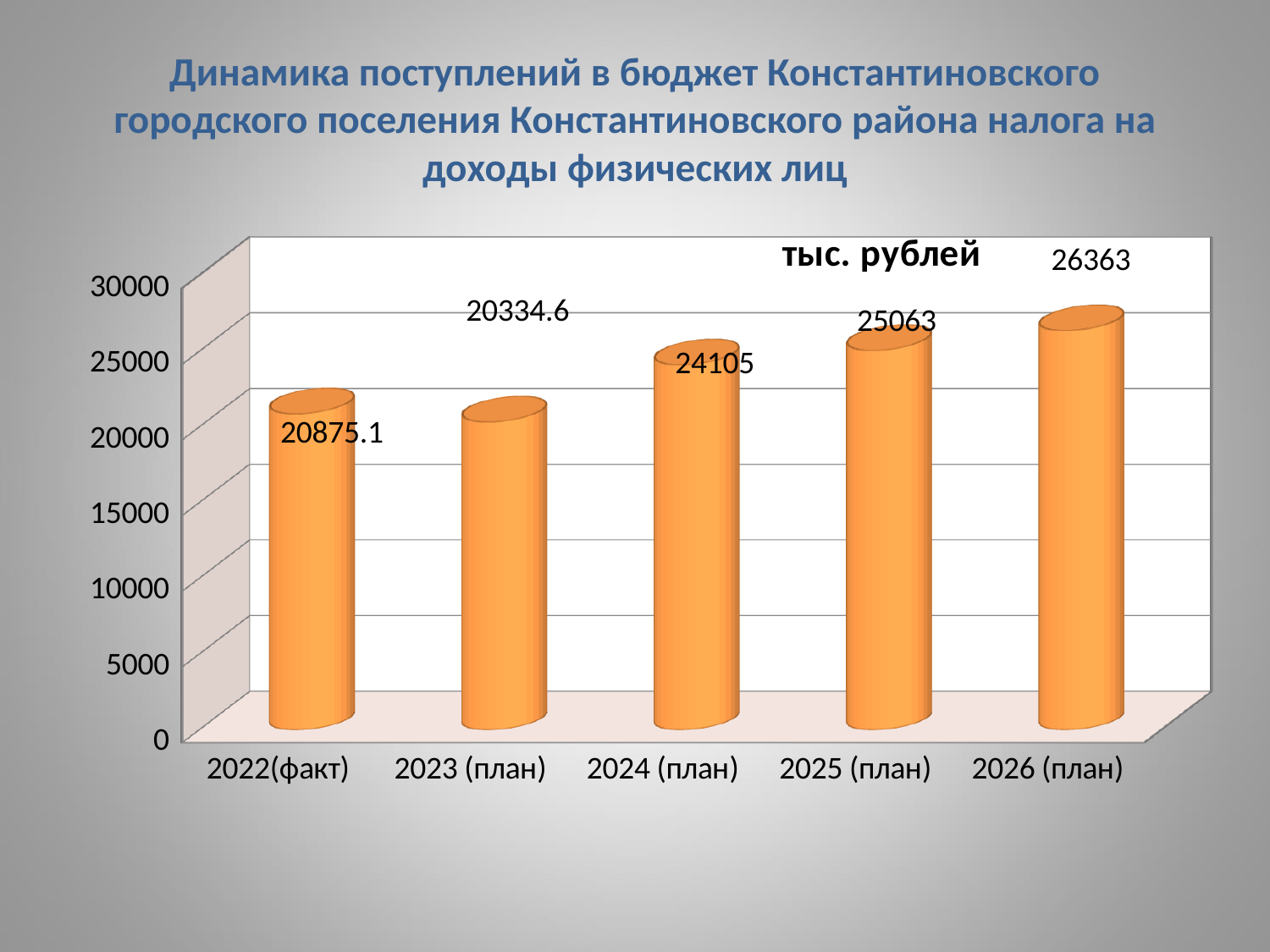
What is the value for 2023 (план)? 20334.6 What is the difference between the values for 2026 (план) and 2025 (план)? 1300 What is the difference between the values for 2024 (план) and 2023 (план)? 3770.4 Which is larger, the value for 2022(факт) or the value for 2023 (план)? 2022(факт) In what units are the values given, according to the label on the chart? тыс. рублей Which year has the highest value? 2026 (план) What kind of chart is shown on the slide? bar chart What is the value for 2022(факт)? 20875.1 How many years are shown on the x axis? 5 What is the value for 2025 (план)? 25063 Is the value for 2024 (план) greater or less than 25000? less Which year has the lowest value? 2023 (план)